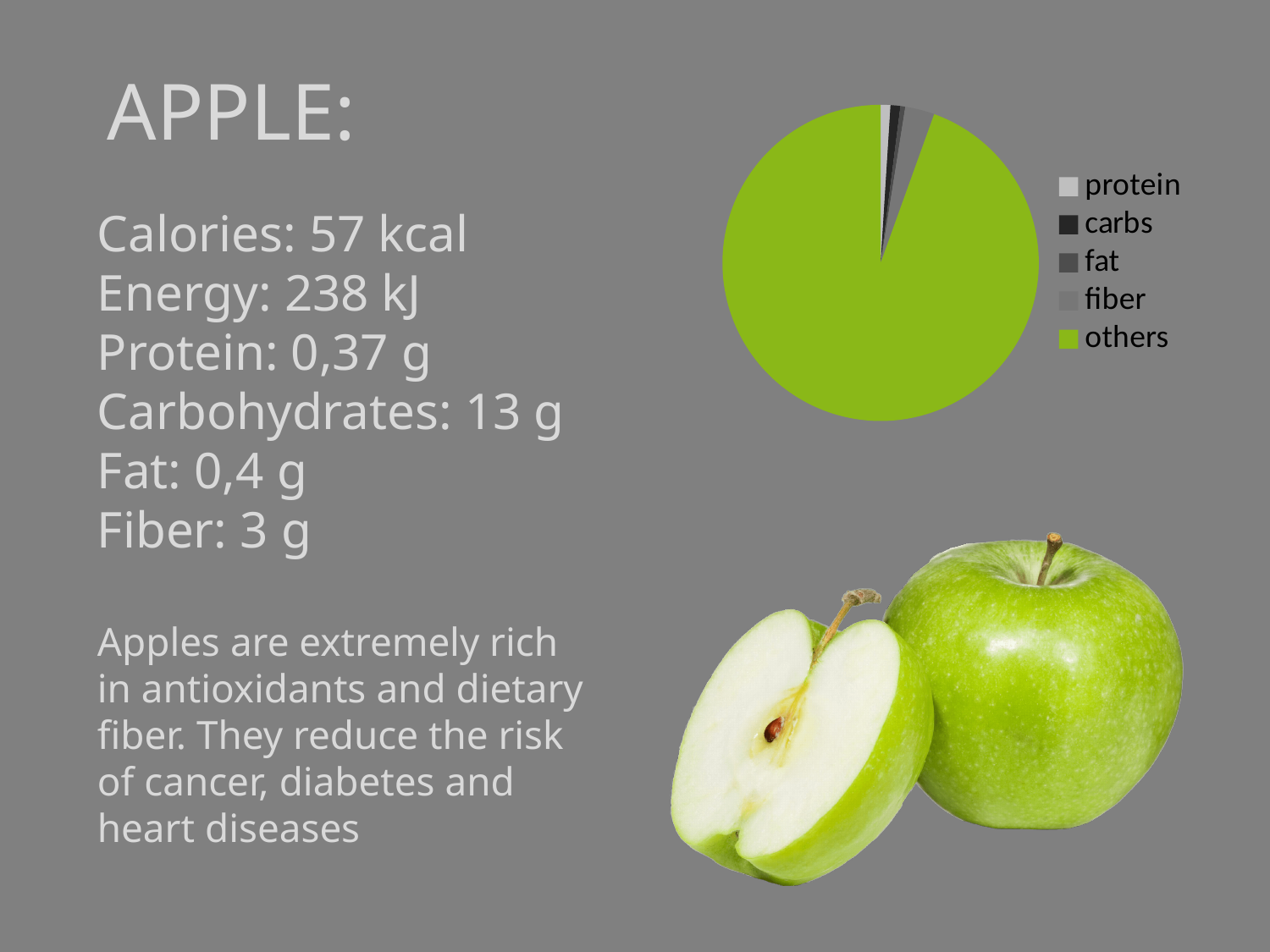
What are the legend entries of the pie chart, in order? protein, carbs, fat, fiber, others How many categories does the pie chart's legend list? 5 What colour is the others slice in the pie chart? green What kind of chart is shown on the slide? pie chart Which is larger in the pie chart, the slice for others or the slice for protein? others Which is larger in the pie chart, the slice for fat or the slice for others? others Which category takes up the largest share of the pie chart? others